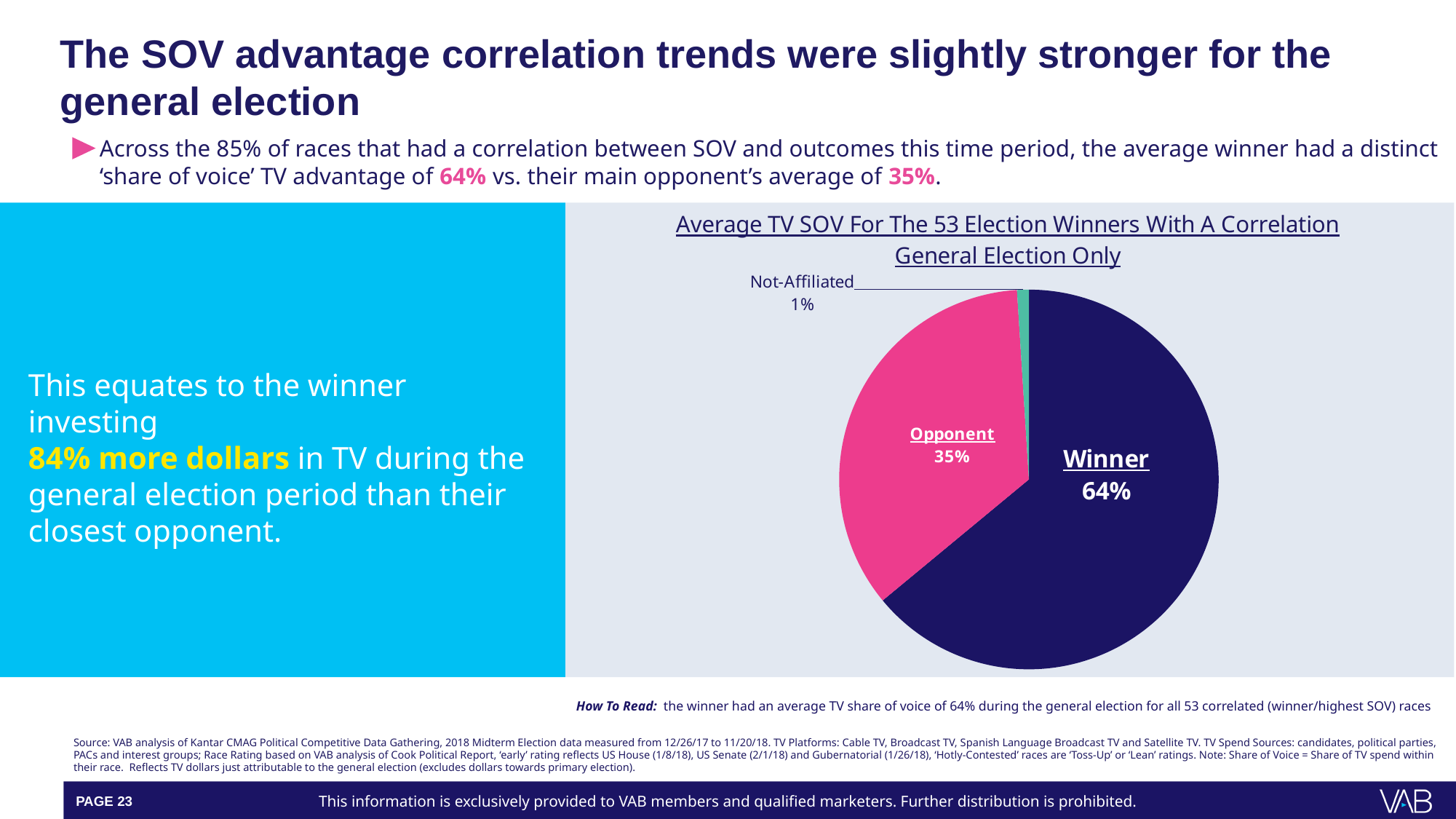
Which is larger, the Opponent slice or the Not-Affiliated slice? Opponent What is the value of the Not-Affiliated slice? 1% What is the average TV SOV for the Opponent slice? 35% What is the average TV SOV for the Winner slice? 64% Which slice of the pie is the smallest? Not-Affiliated Which slice of the pie is the largest? Winner What colour is the Opponent slice of the pie chart? Pink How many slices does the pie chart have? 3 What share of the pie does the Winner slice represent? 64% What is the difference in percentage points between the Winner and Opponent slices? 29 What is the title of the pie chart? Average TV SOV For The 53 Election Winners With A Correlation General Election Only What kind of chart is shown on the slide? Pie chart